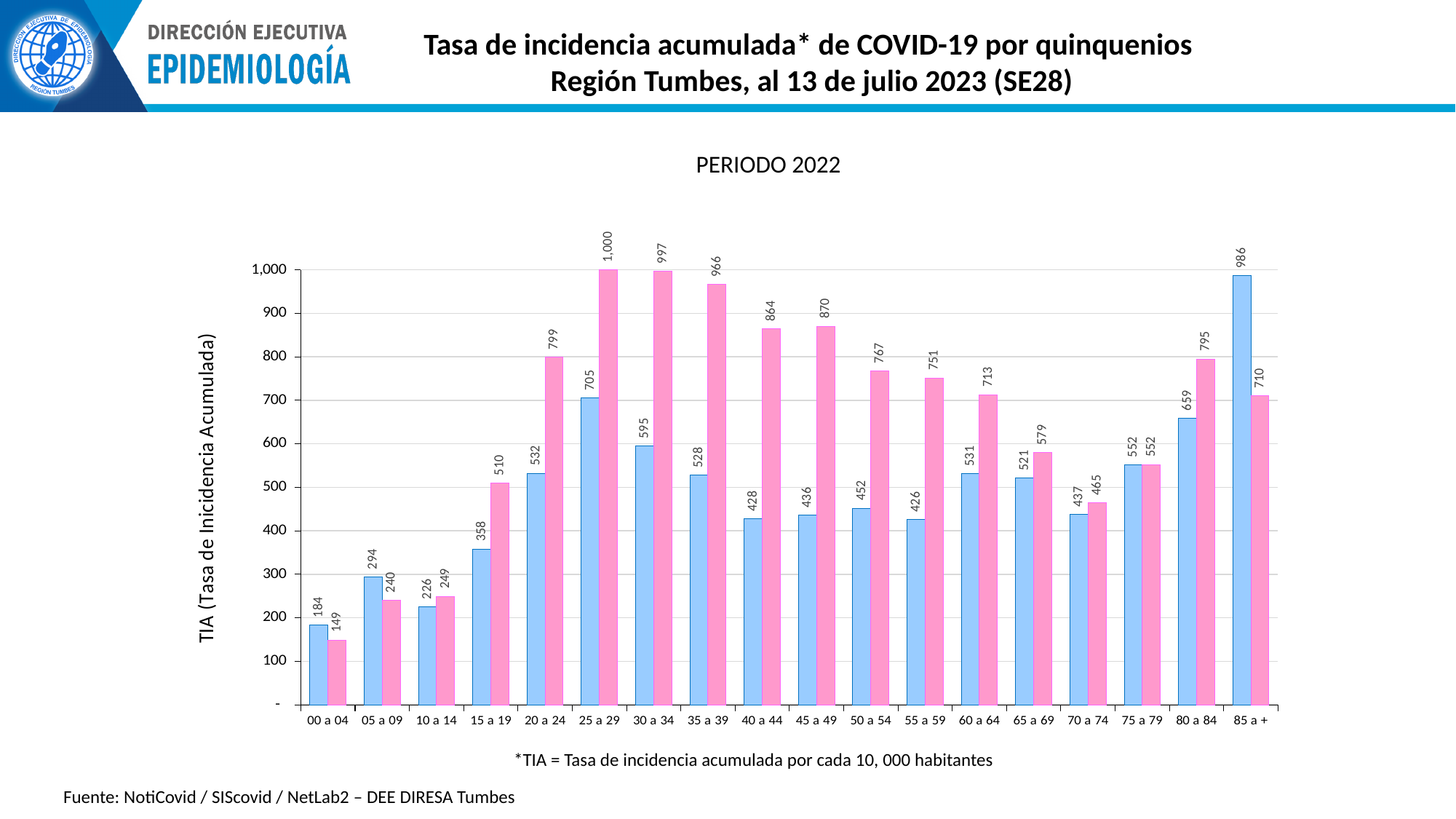
Which age group has the lowest blue bar? 00 a 04 Which age group has the highest pink bar? 25 a 29 What is the value of the pink bar for the 25 a 29 age group? 1,000 What is the title shown above the chart? PERIODO 2022 Is the value of the pink bar for 40 a 44 greater or less than 800? greater What is the value of the pink bar for the 00 a 04 age group? 149 What is the value of the blue bar for the 85 a + age group? 986 For the 85 a + age group, which bar is larger, the blue or the pink? blue How many age groups are shown on the x axis? 18 What is the difference between the pink and blue bars for the 20 a 24 age group? 267 What is the label of the y axis? TIA (Tasa de Incidencia Acumulada) What kind of chart is shown on the slide? bar chart